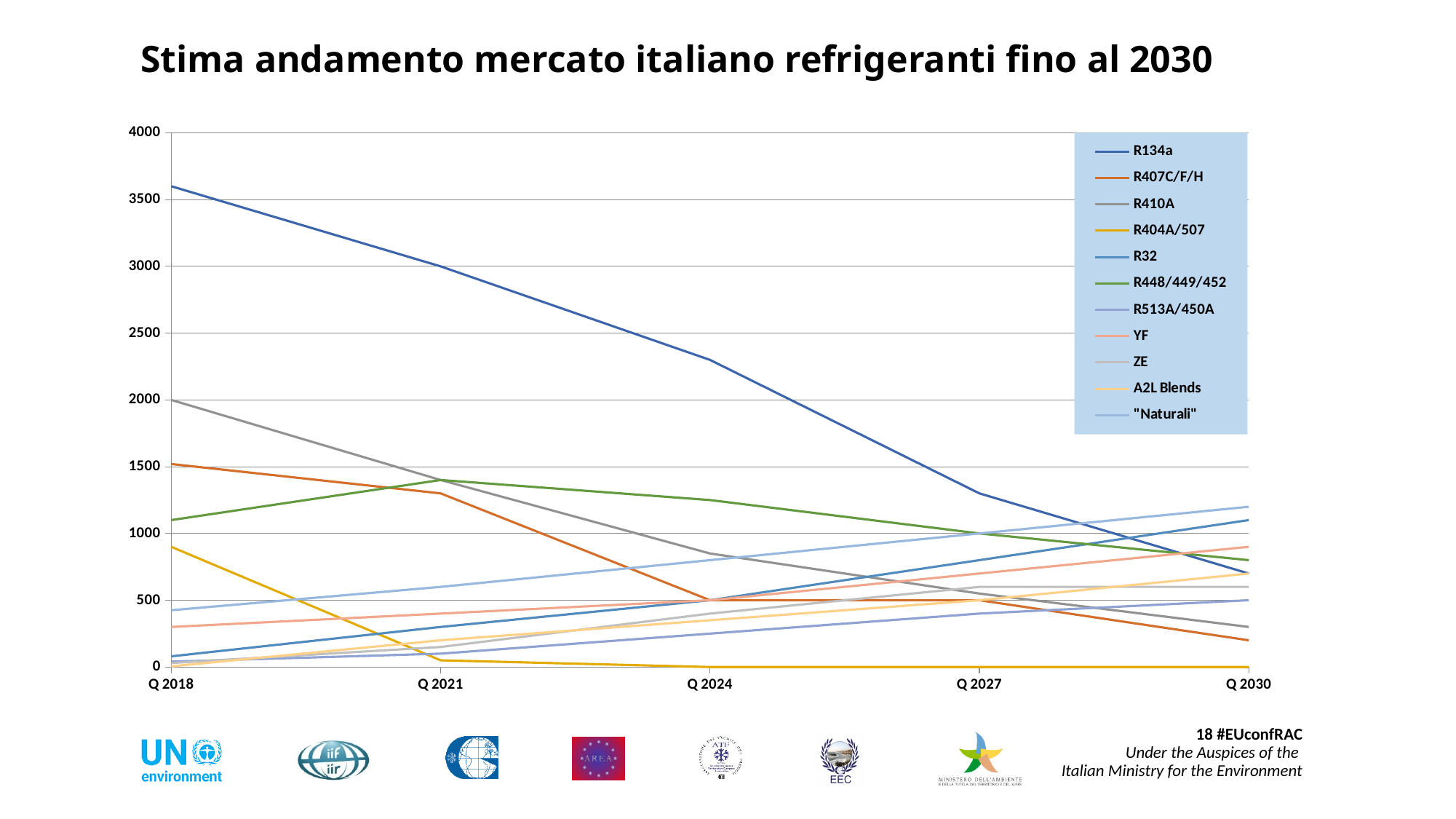
At Q 2030, which is larger: R134a or R407C/F/H? R134a Is the value for R134a at Q 2018 greater or less than 3500? greater Is the value for R410A at Q 2030 greater or less than 500? less How many series does the legend list? 11 Does the "Naturali" line rise or fall from Q 2018 to Q 2030? rise Does the R134a line rise or fall from Q 2018 to Q 2030? fall What is the title of the chart? Stima andamento mercato italiano refrigeranti fino al 2030 What kind of chart is shown on the slide? line chart How many points are shown along the x axis? 5 Which series has the highest value at Q 2018? R134a Is the value for R448/449/452 at Q 2021 greater or less than 1000? greater Which series has the lowest value at Q 2030? R404A/507